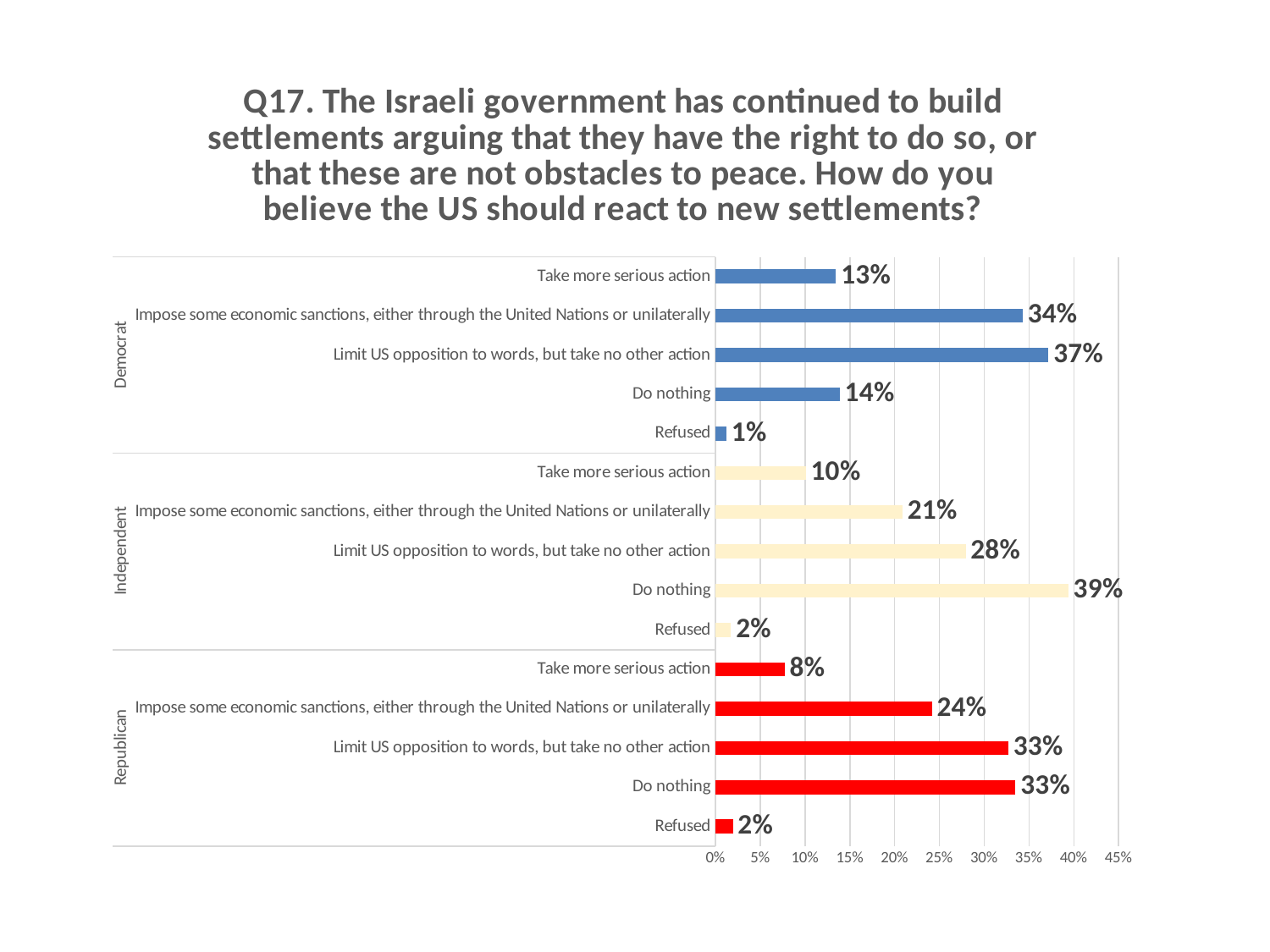
Which group has a larger percentage for "Impose some economic sanctions, either through the United Nations or unilaterally": Democrats or Independents? Democrats What is the total of the "Do nothing" percentages across Democrats, Independents and Republicans? 86% What is the difference between the Democrat and Republican percentages for "Take more serious action"? 5% Which response has the lowest percentage among Independents? Refused What percentage of Republicans chose "Impose some economic sanctions, either through the United Nations or unilaterally"? 24% What kind of chart is shown on the slide? Bar chart Is the Independent value for "Limit US opposition to words, but take no other action" greater or less than 25%? greater What percentage of Independents chose "Do nothing"? 39% What colour are the bars for the Republican group? Red How many bars are plotted in the chart in total? 15 Which response has the highest percentage among Democrats? Limit US opposition to words, but take no other action What percentage of Democrats chose "Limit US opposition to words, but take no other action"? 37%